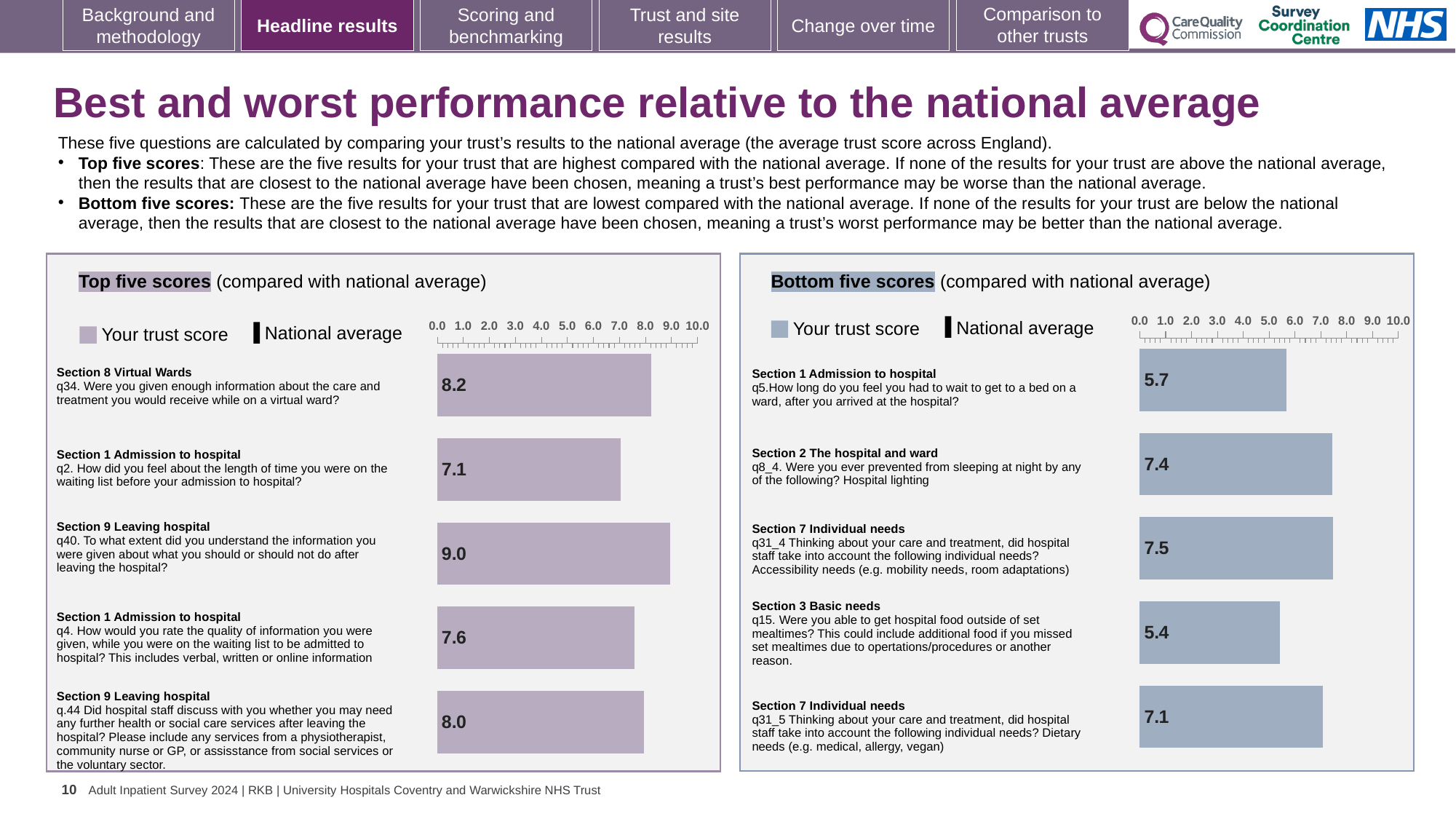
In the Bottom five scores chart, which question has the highest trust score? q31_4 In the Bottom five scores chart, which has the larger trust score, q5 or q31_5? q31_5 What kind of chart is used in the Top five scores panel? Bar chart In the Top five scores chart, what is the trust score for q34 about information on care and treatment while on a virtual ward? 8.2 In the Bottom five scores chart, what is the trust score for q15 about getting hospital food outside of set mealtimes? 5.4 In the Top five scores chart, which question has the lowest trust score? q2 In the Top five scores chart, what is the difference between the trust scores for q40 and q2? 1.9 How many bars are shown in the Bottom five scores chart? 5 In the Bottom five scores chart, which question has the lowest trust score? q15 In the Bottom five scores chart, what is the trust score for q8_4 about being prevented from sleeping by hospital lighting? 7.4 In the Top five scores chart, what is the trust score for q40 about understanding information given about what to do after leaving hospital? 9.0 In the Top five scores chart, which question has the highest trust score? q40